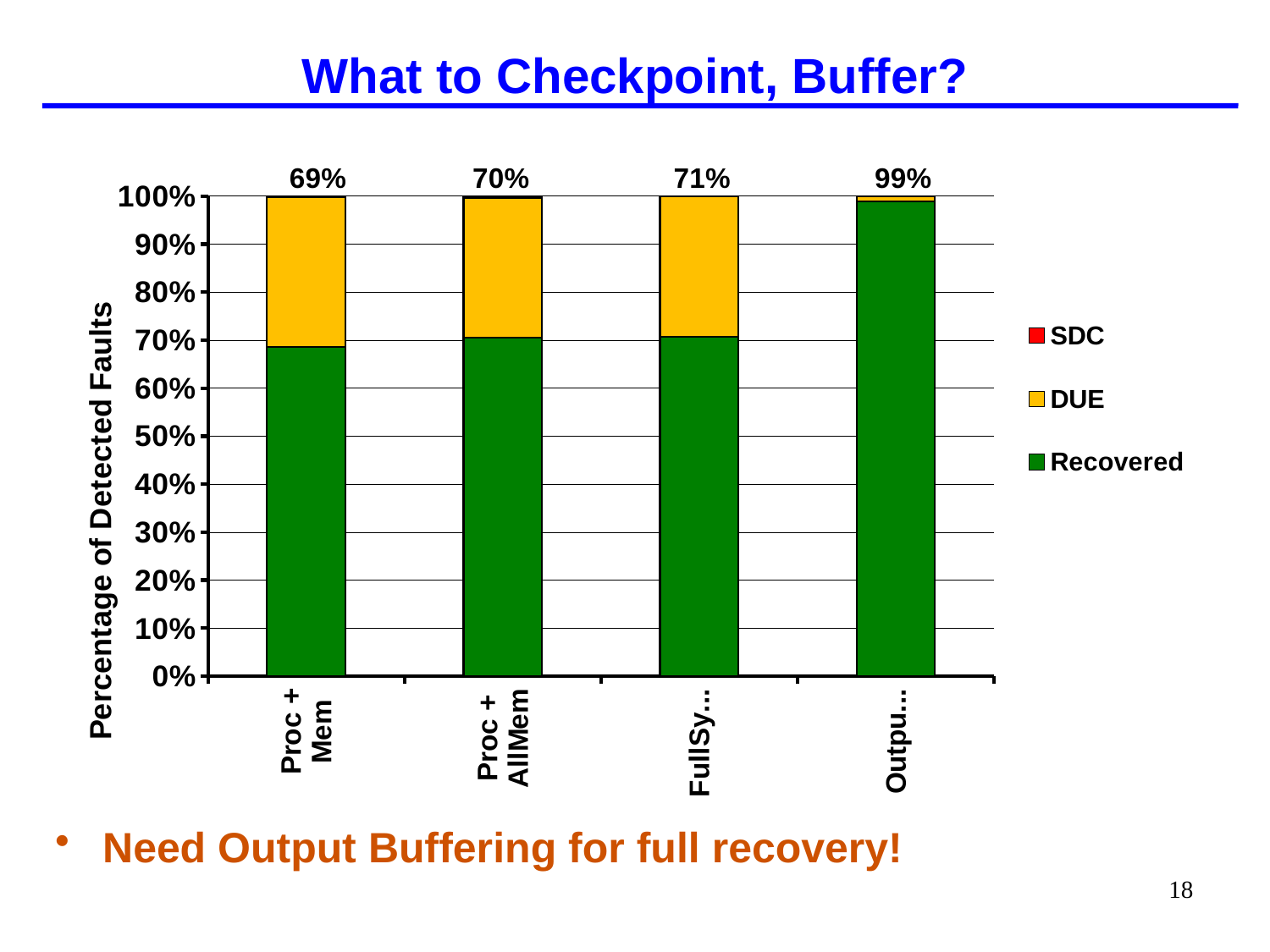
What value is printed above the Proc + Mem bar? 69% How many series does the legend list? 3 Which has the larger printed value, Proc + Mem or Proc + AllMem? Proc + AllMem What is the title of the vertical axis? Percentage of Detected Faults What is the difference between the value printed above the rightmost bar and the value printed above the Proc + Mem bar? 30% Which category has the lowest value printed above its bar? Proc + Mem What kind of chart is shown on the slide? bar chart Do the values printed above the bars rise or fall from left to right? rise What value is printed above the rightmost bar? 99% What is the highest value printed above the bars? 99% What value is printed above the Proc + AllMem bar? 70% How many bars (categories) are plotted in the chart? 4